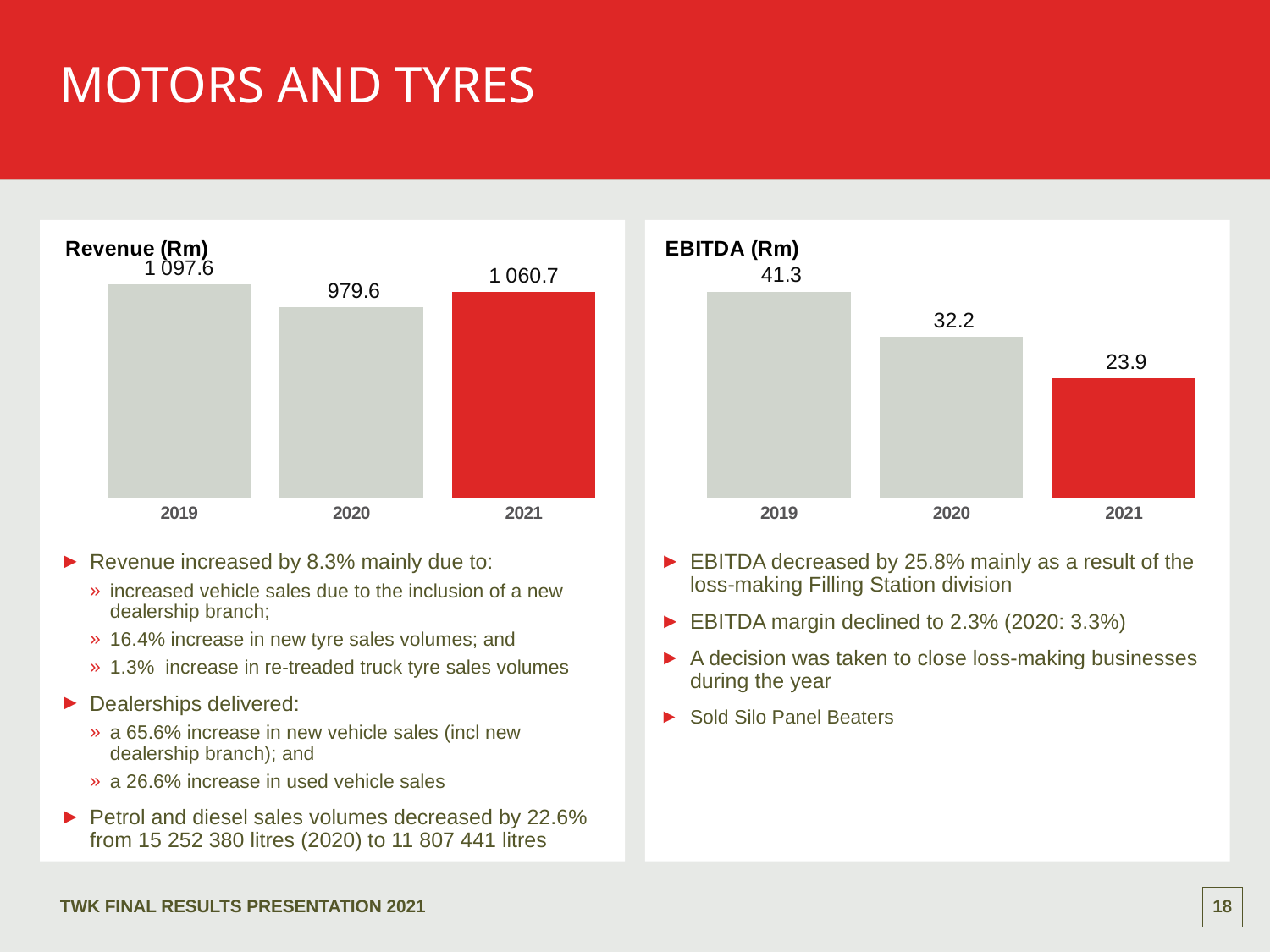
In the Revenue (Rm) chart, what is the value for 2020? 979.6 In the Revenue (Rm) chart, what is the difference between the 2021 and 2020 values? 81.1 In the Revenue (Rm) chart, what is the value for 2021? 1 060.7 In the EBITDA (Rm) chart, what is the difference between the 2019 and 2020 values? 9.1 What type of chart is the Revenue (Rm) chart? bar chart In the EBITDA (Rm) chart, what is the value for 2021? 23.9 In the EBITDA (Rm) chart, what is the value for 2019? 41.3 In the EBITDA (Rm) chart, do the values rise or fall from 2019 to 2021? fall In the EBITDA (Rm) chart, which year has the lowest EBITDA? 2021 In the Revenue (Rm) chart, which year has the highest revenue? 2019 In the Revenue (Rm) chart, which year has the lowest revenue? 2020 How many years are shown in the EBITDA (Rm) chart? 3